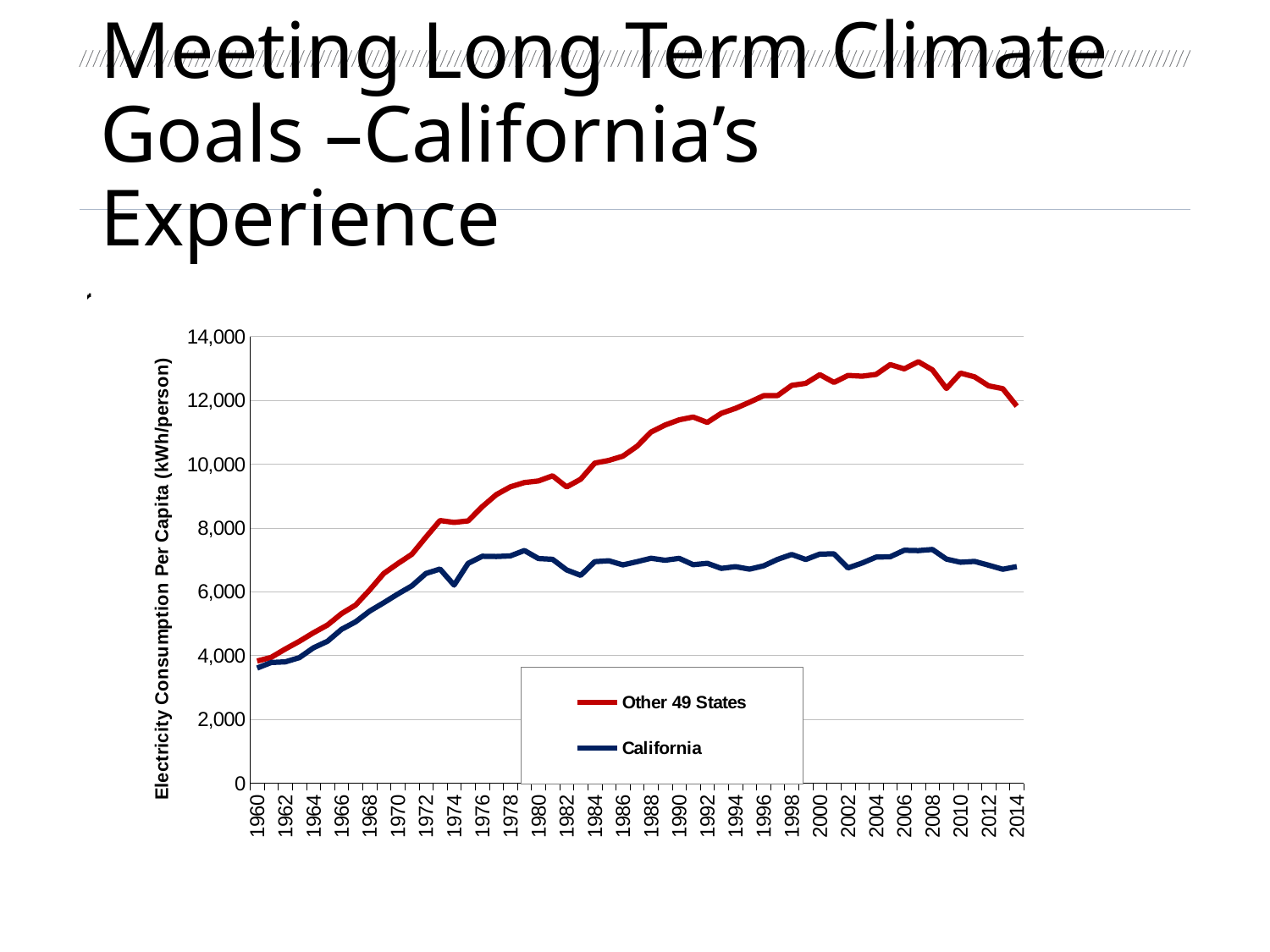
Is the value for Other 49 States in 1980 greater or less than 8,000? greater Is the value for Other 49 States in 2006 greater or less than 12,000? greater Is the value for Other 49 States in 1960 greater or less than 6,000? less Does the Other 49 States line rise or fall between 1960 and 2006? rise How many series does the legend list? 2 Does the California line rise or fall between 1960 and 1976? rise What are the two series named in the legend? Other 49 States and California In 2014, which series has the higher value, Other 49 States or California? Other 49 States What is the title of the vertical axis? Electricity Consumption Per Capita (kWh/person) In 1990, which series has the higher value, Other 49 States or California? Other 49 States What kind of chart is shown on the slide? line chart